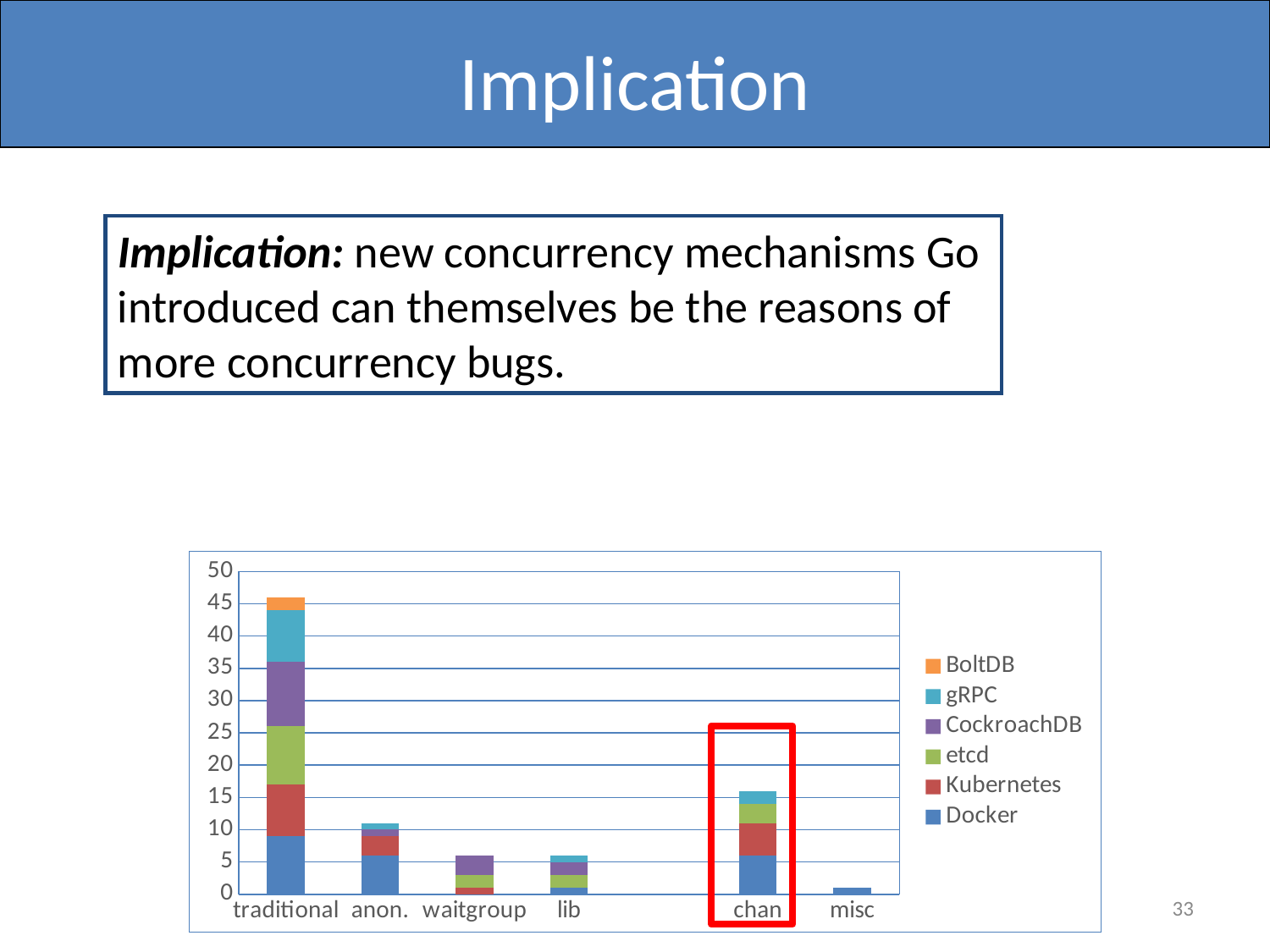
How many series does the chart's legend list? 6 Is the total value for chan greater or less than 20? less Which series is listed at the bottom of the legend? Docker Is the total value for misc greater or less than 5? less Is the total value for traditional greater or less than 40? greater Which stacked bar is taller, traditional or chan? traditional What kind of chart is shown on the slide? stacked bar chart Which category on the x axis is highlighted with a red box? chan Which category has the shortest stacked bar? misc Which category has the tallest stacked bar? traditional Which stacked bar is taller, chan or anon.? chan How many categories are shown on the x axis of the chart? 6